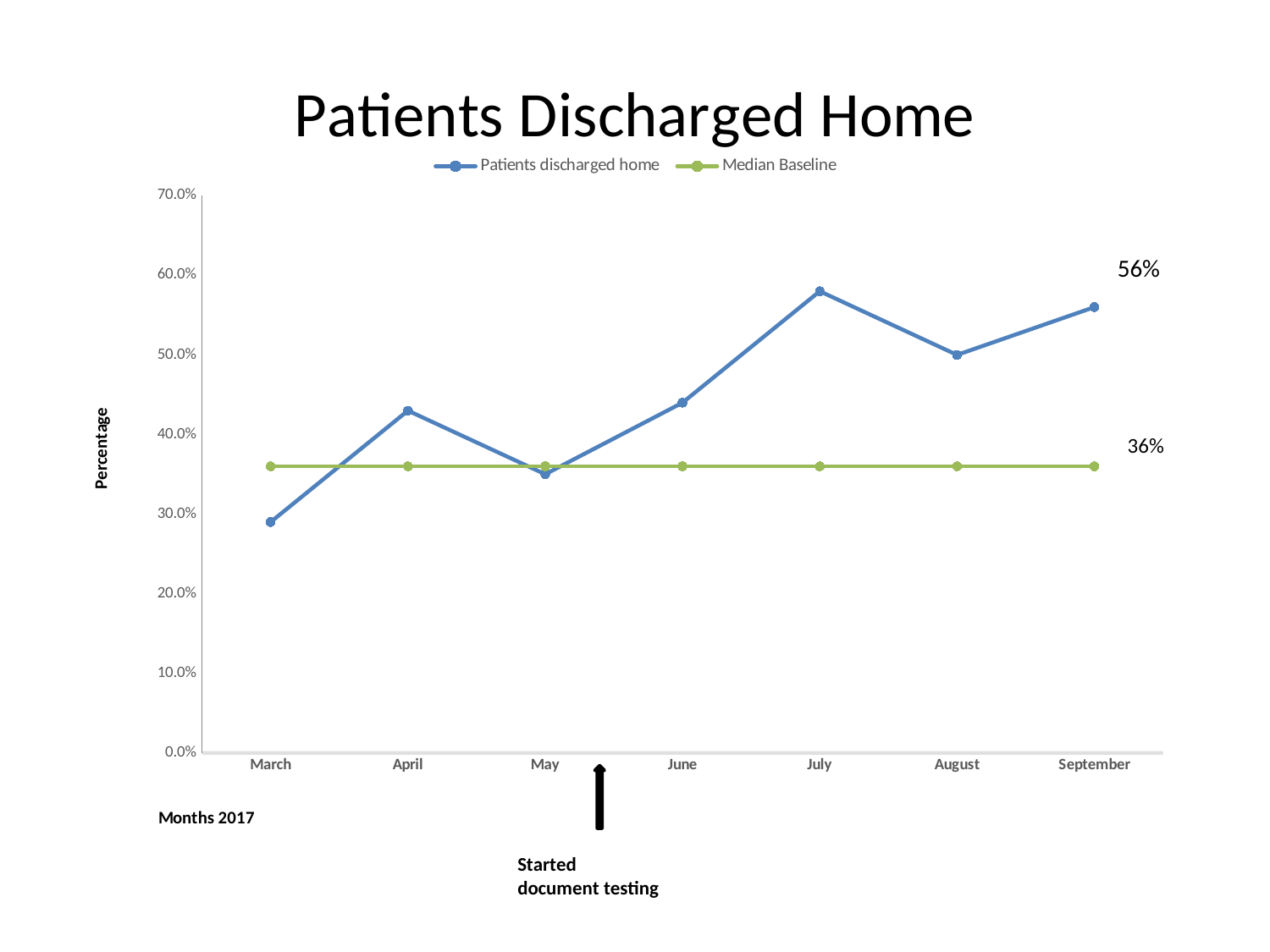
In which month is the value for Patients discharged home highest? July Is the value for Patients discharged home in July greater or less than 50.0%? greater Is the value for Patients discharged home in March greater or less than 30.0%? less What value is labelled for the Median Baseline? 36% Does the Patients discharged home line rise or fall from May to July? rise What kind of chart is shown on the slide? line chart Which is larger, the value for Patients discharged home in April or in July? July What is the title of the chart? Patients Discharged Home In which month is the value for Patients discharged home lowest? March How many months are plotted along the x axis? 7 How many series does the legend list? 2 What value is labelled for Patients discharged home in September? 56%